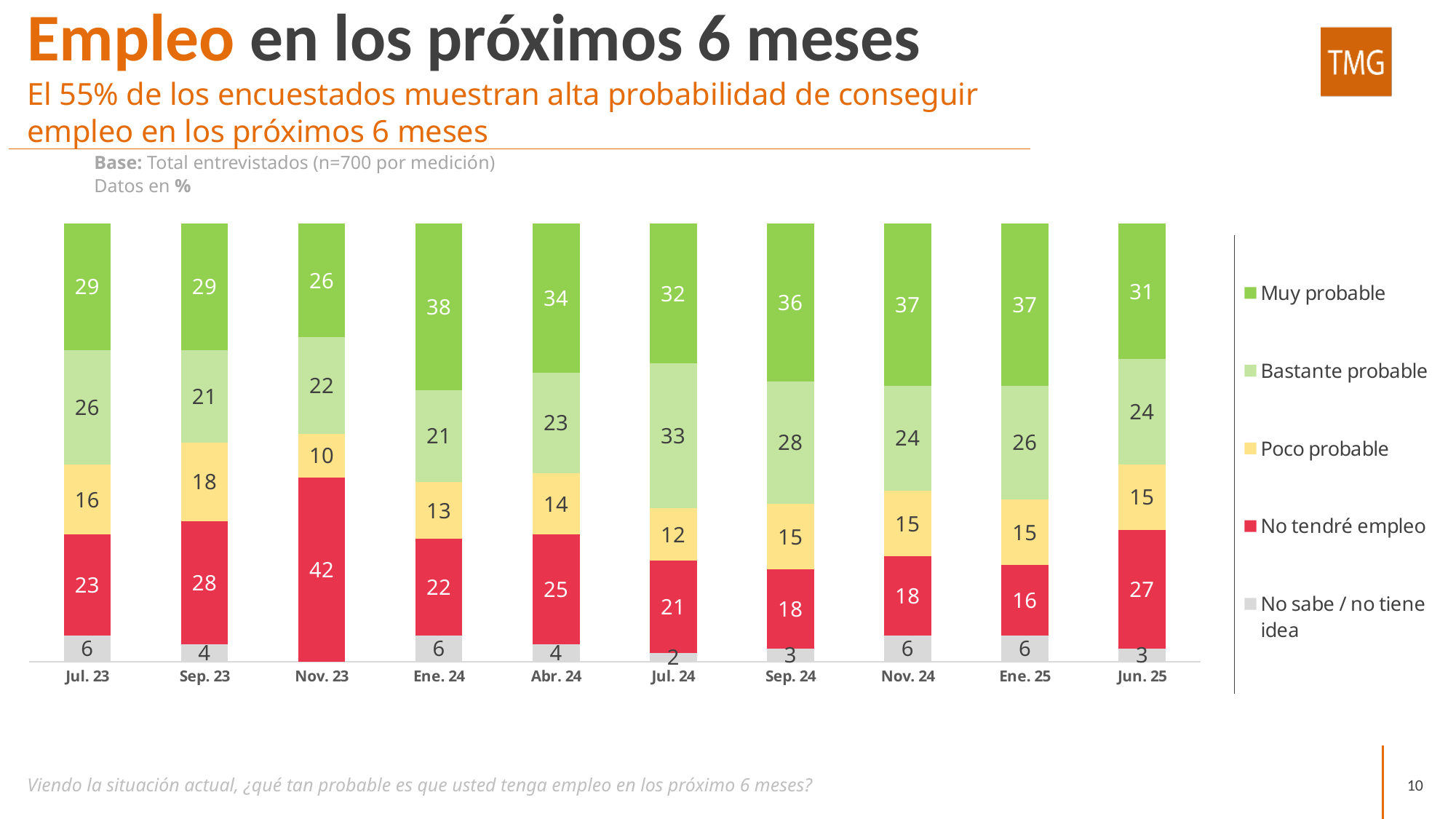
What kind of chart is shown on the slide? Stacked bar chart What is the value for "Muy probable" in Ene. 24? 38 How many series does the legend list? 5 What is the value for "Poco probable" in Sep. 23? 18 Which is larger: "Muy probable" in Jul. 23 or "Muy probable" in Nov. 24? Nov. 24 In which period is the "Muy probable" value highest? Ene. 24 What is the value for "Bastante probable" in Jul. 24? 33 What is the total of the stacked bar for Jun. 25? 100 How many periods (bars) are shown on the x axis? 10 What is the difference between the "No tendré empleo" values for Nov. 23 and Ene. 25? 26 In which period is the "No tendré empleo" value lowest? Ene. 25 What is the value for "No tendré empleo" in Nov. 23? 42